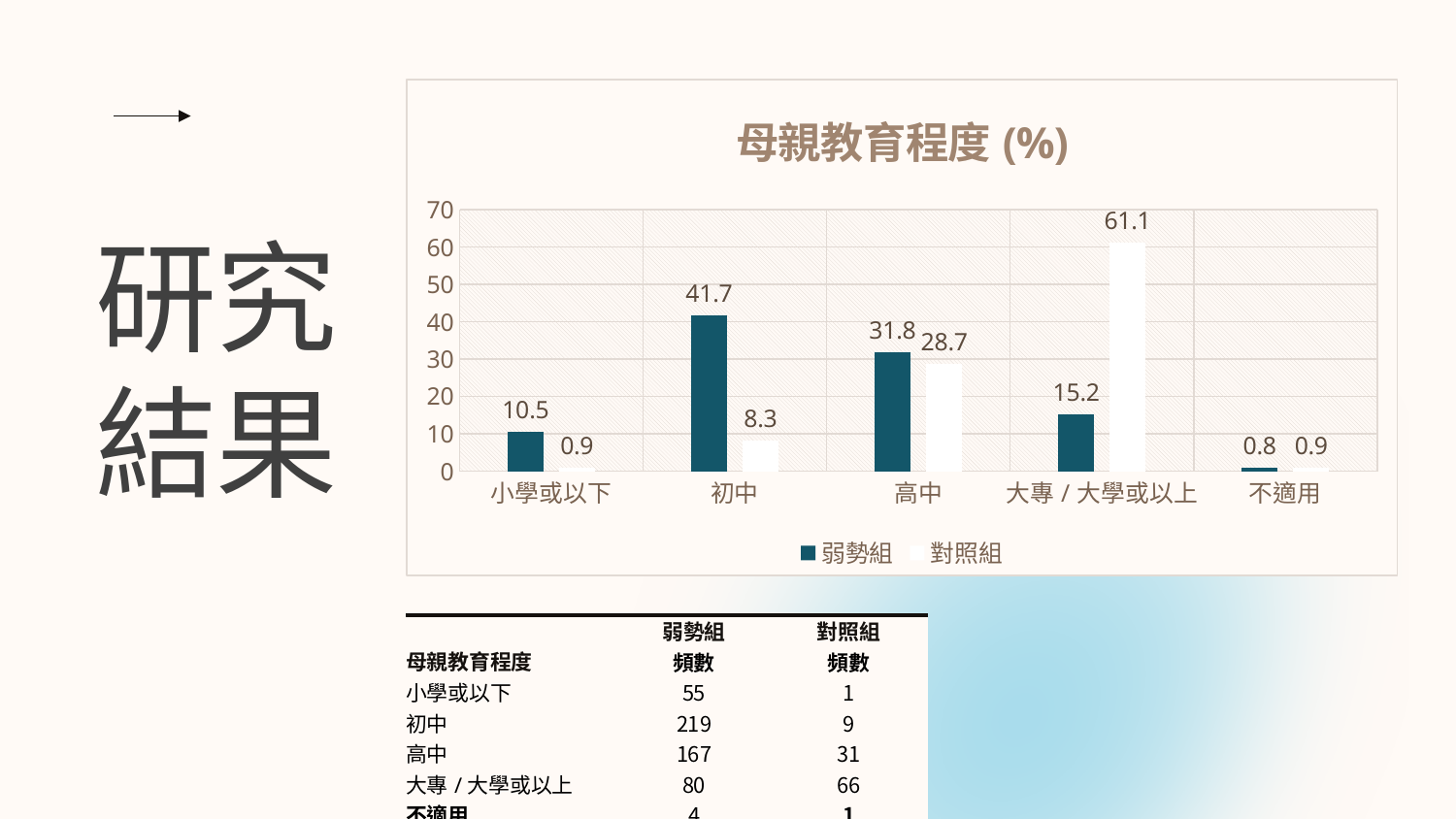
Which category has the lowest value for 弱勢組? 不適用 What kind of chart is shown? bar chart How many series does the legend list? 2 What is the value for 弱勢組 in the 初中 category? 41.7 What is the value for 對照組 in the 大專 / 大學或以上 category? 61.1 Which category has the highest value for 對照組? 大專 / 大學或以上 What is the difference between 弱勢組 and 對照組 in the 高中 category? 3.1 How many categories are shown on the x axis? 5 Which is larger in the 大專 / 大學或以上 category, 弱勢組 or 對照組? 對照組 Which category has the highest value for 弱勢組? 初中 What is the value for 對照組 in the 小學或以下 category? 0.9 What is the title of the chart? 母親教育程度 (%)